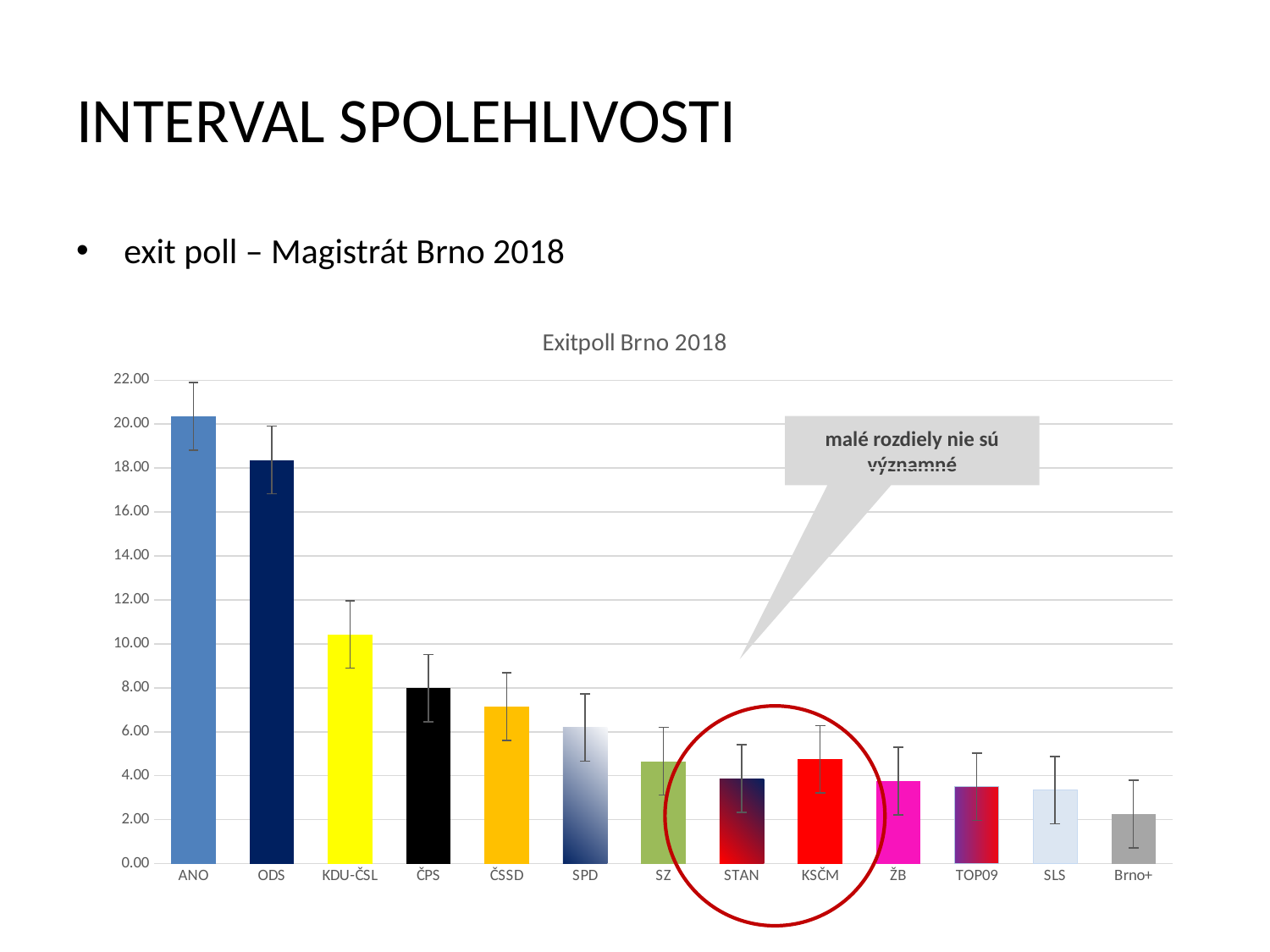
What kind of chart is shown on the slide? bar chart Which party has the lowest bar in the chart? Brno+ Which party has the highest bar in the chart? ANO Is the value for ANO greater or less than 20.00? greater Which has a larger value, ANO or ODS? ANO Which has a larger value, KDU-ČSL or ČSSD? KDU-ČSL How many parties (categories) are shown on the x axis of the chart? 13 What is the title of the chart? Exitpoll Brno 2018 Is the value for ODS greater or less than 18.00? greater Is the value for KDU-ČSL greater or less than 10.00? greater Do the bar values generally rise or fall from left to right along the x axis? fall